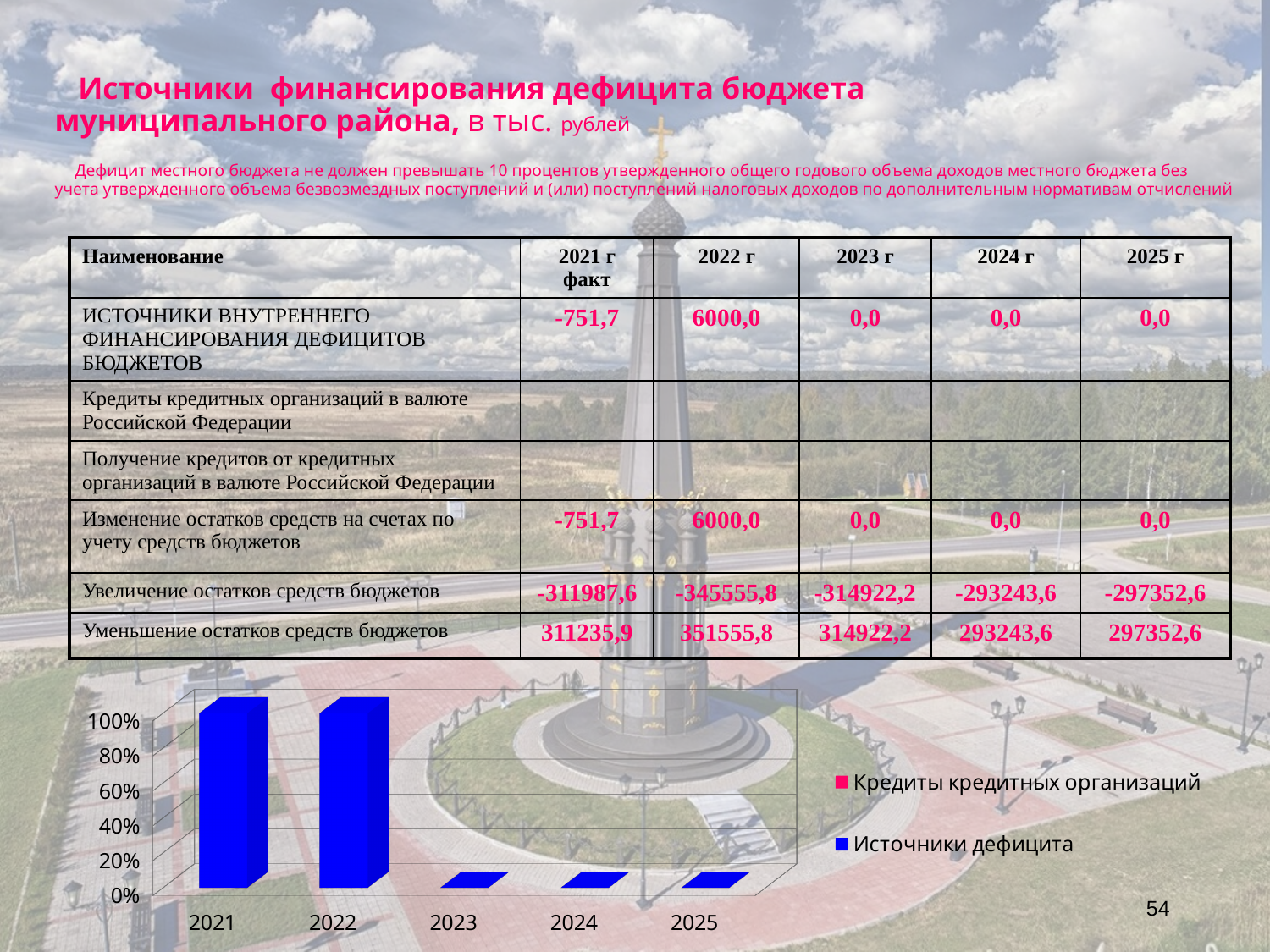
Which series in the bar chart legend is shown in blue? Источники дефицита In the bar chart, which is larger: the bar for 2022 or the bar for 2024? 2022 Is the bar for 2021 in the chart greater or less than 80%? greater What kind of chart is shown at the bottom of the slide? bar chart Is the bar for 2025 in the chart greater or less than 40%? less Is the bar for 2022 in the chart greater or less than 60%? greater How many series does the legend of the bar chart list? 2 In the bar chart, do the bars rise or fall from 2022 to 2023? fall Which series in the bar chart legend is shown in pink? Кредиты кредитных организаций In the bar chart, which is larger: the bar for 2021 or the bar for 2025? 2021 How many years are shown on the x axis of the bar chart? 5